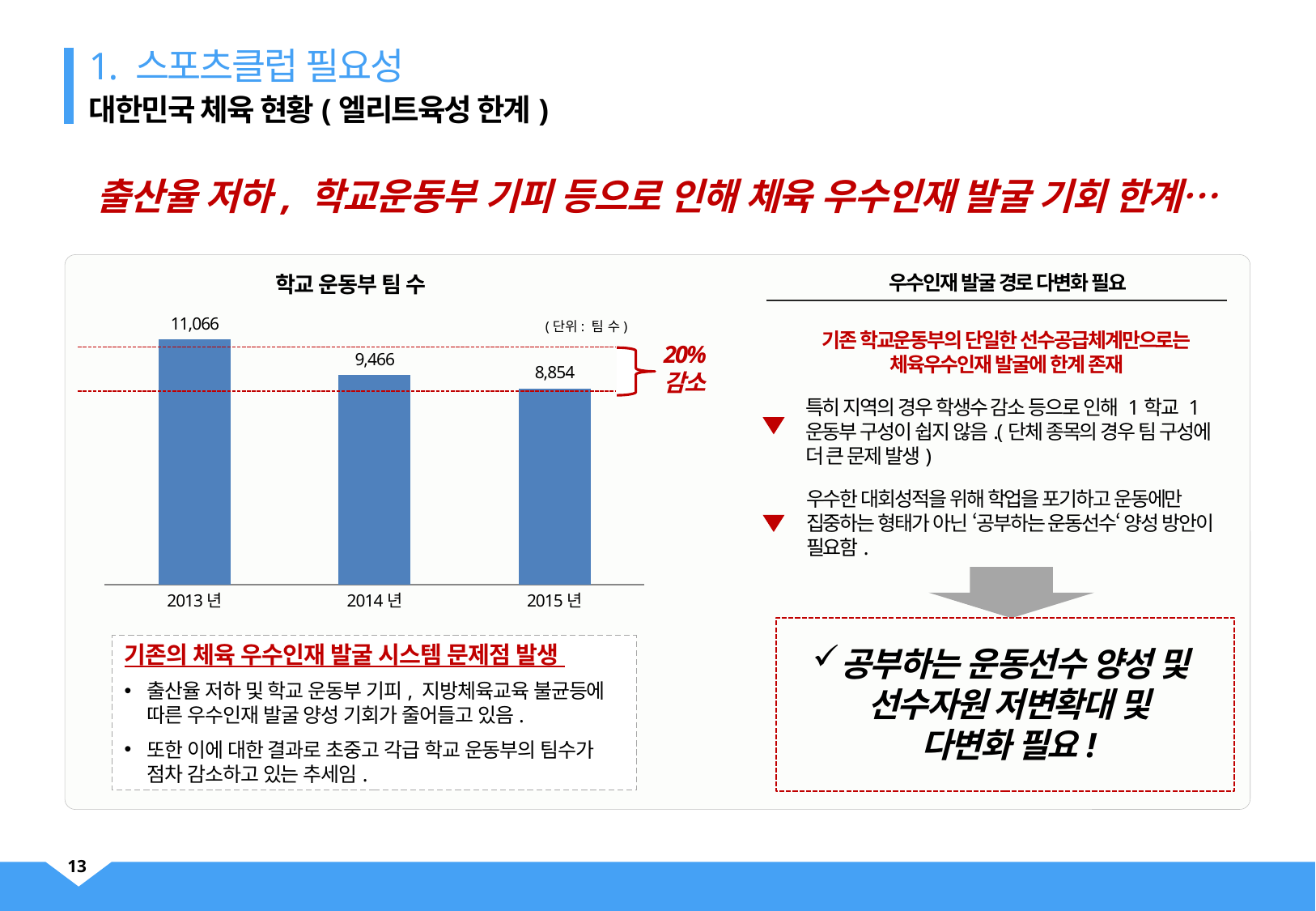
In the 학교 운동부 팀 수 chart, which is larger, the value for 2013 년 or 2014 년? 2013 년 What kind of chart is the 학교 운동부 팀 수 chart? bar chart Do the values in the 학교 운동부 팀 수 chart rise or fall from 2013 년 to 2015 년? fall Which year has the highest value in the 학교 운동부 팀 수 chart? 2013 년 How many years are shown in the 학교 운동부 팀 수 chart? 3 What is the value for 2014 년 in the 학교 운동부 팀 수 chart? 9,466 What is the difference between the 2013 년 and 2015 년 values in the 학교 운동부 팀 수 chart? 2,212 What is the difference between the 2014 년 and 2015 년 values in the 학교 운동부 팀 수 chart? 612 Which year has the lowest value in the 학교 운동부 팀 수 chart? 2015 년 What is the value for 2013 년 in the 학교 운동부 팀 수 chart? 11,066 What unit is stated for the values in the 학교 운동부 팀 수 chart? 팀 수 What is the value for 2015 년 in the 학교 운동부 팀 수 chart? 8,854